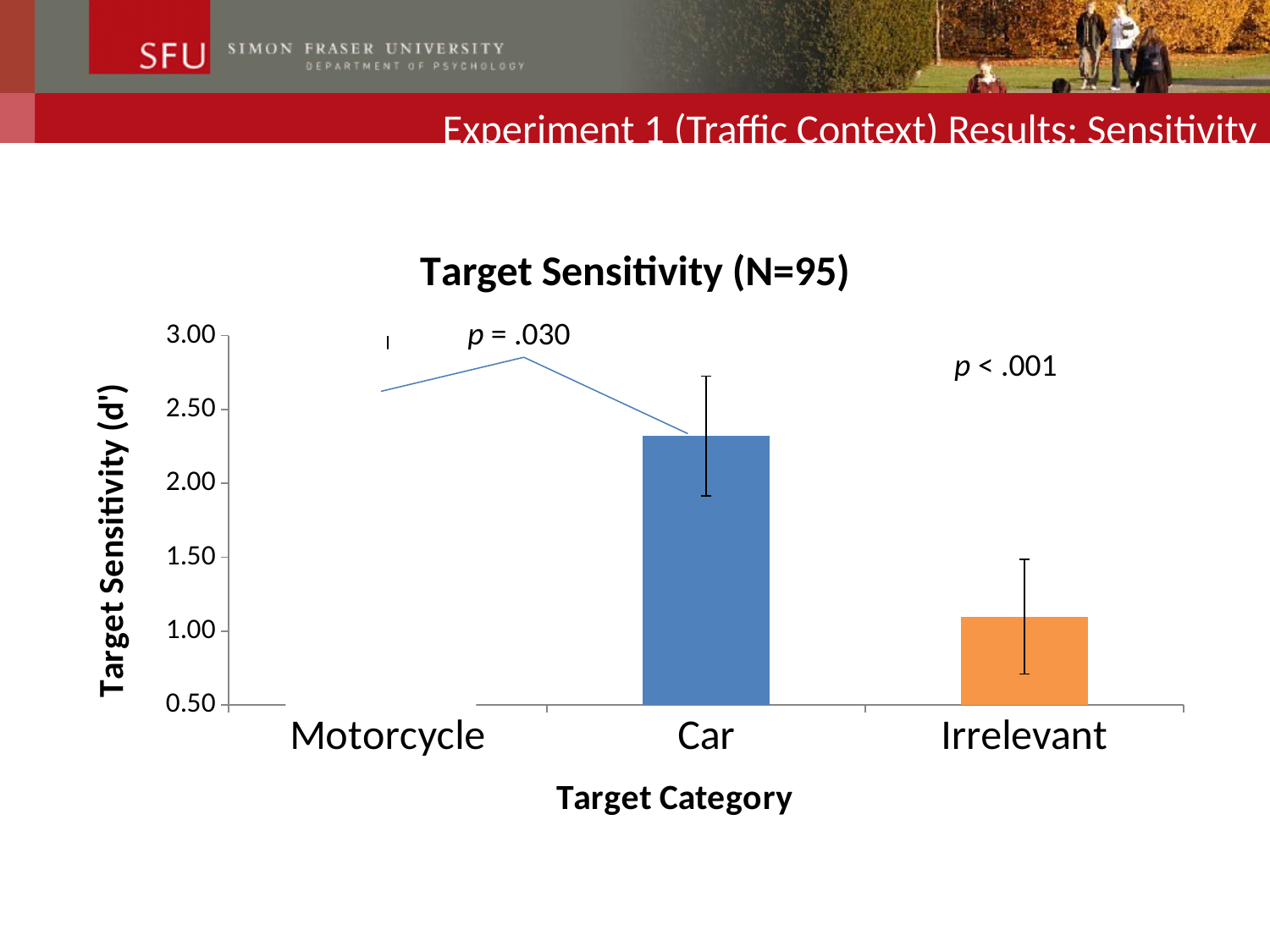
Which has the larger target sensitivity, Car or Irrelevant? Car What is the label on the y axis of the chart? Target Sensitivity (d') How many target categories are labelled on the x axis of the chart? 3 What is the title of the chart? Target Sensitivity (N=95) Is the value for Irrelevant greater or less than 1.50? less Is the value for Car greater or less than 2.00? greater What kind of chart is shown on the slide? bar chart Is the value for Car greater or less than 2.50? less